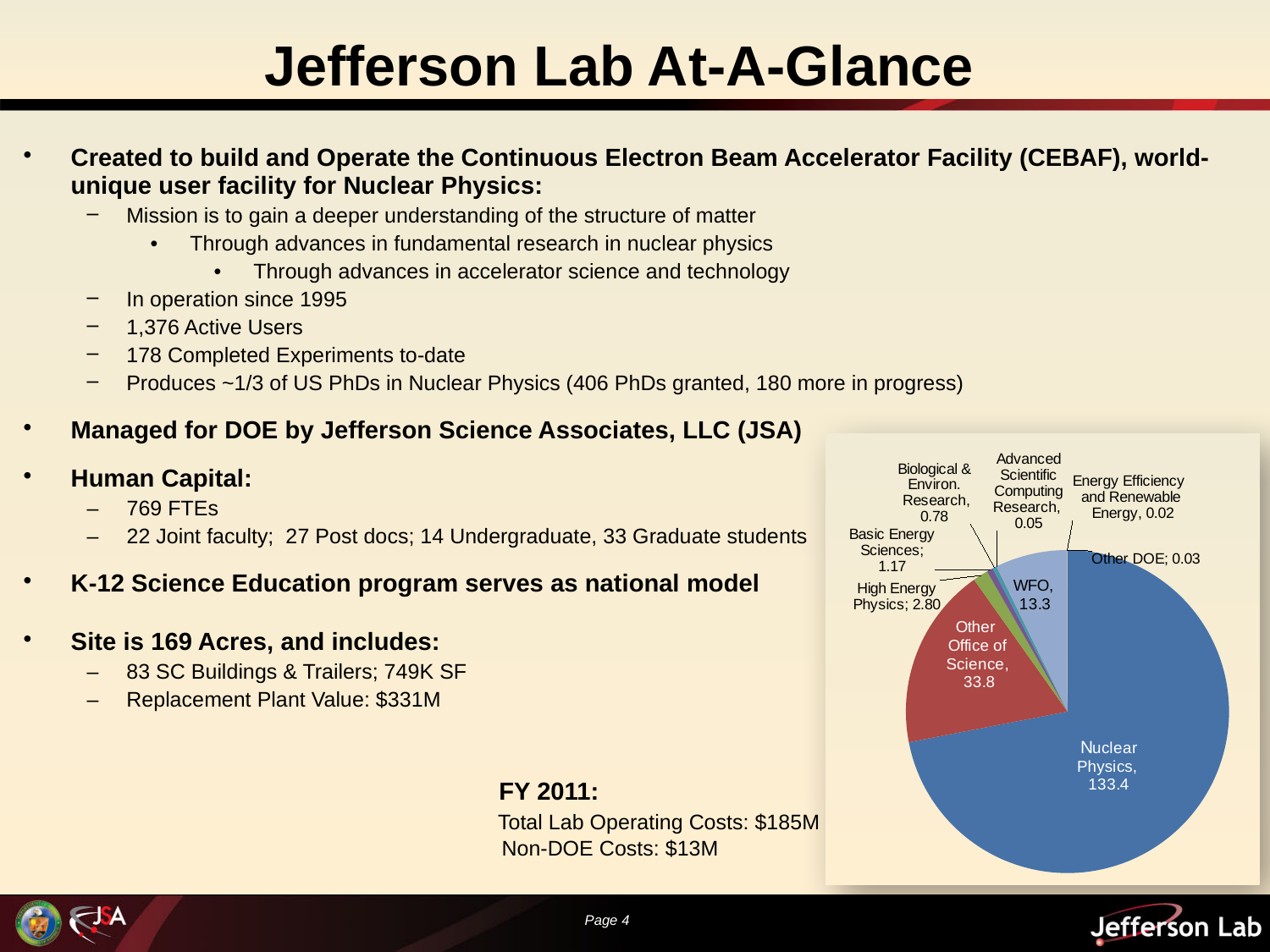
What is the value for Nuclear Physics in the pie chart? 133.4 What is the value for Basic Energy Sciences in the pie chart? 1.17 What is the value for WFO in the pie chart? 13.3 Which category has the smallest value in the pie chart? Energy Efficiency and Renewable Energy What kind of chart is shown on the slide? pie chart Which is larger in the pie chart, WFO or High Energy Physics? WFO What is the value for Other Office of Science in the pie chart? 33.8 What is the value for Other DOE in the pie chart? 0.03 What is the value for High Energy Physics in the pie chart? 2.80 How many slices does the pie chart have? 9 Which category has the largest slice in the pie chart? Nuclear Physics What is the difference between the Nuclear Physics value and the Other Office of Science value? 99.6